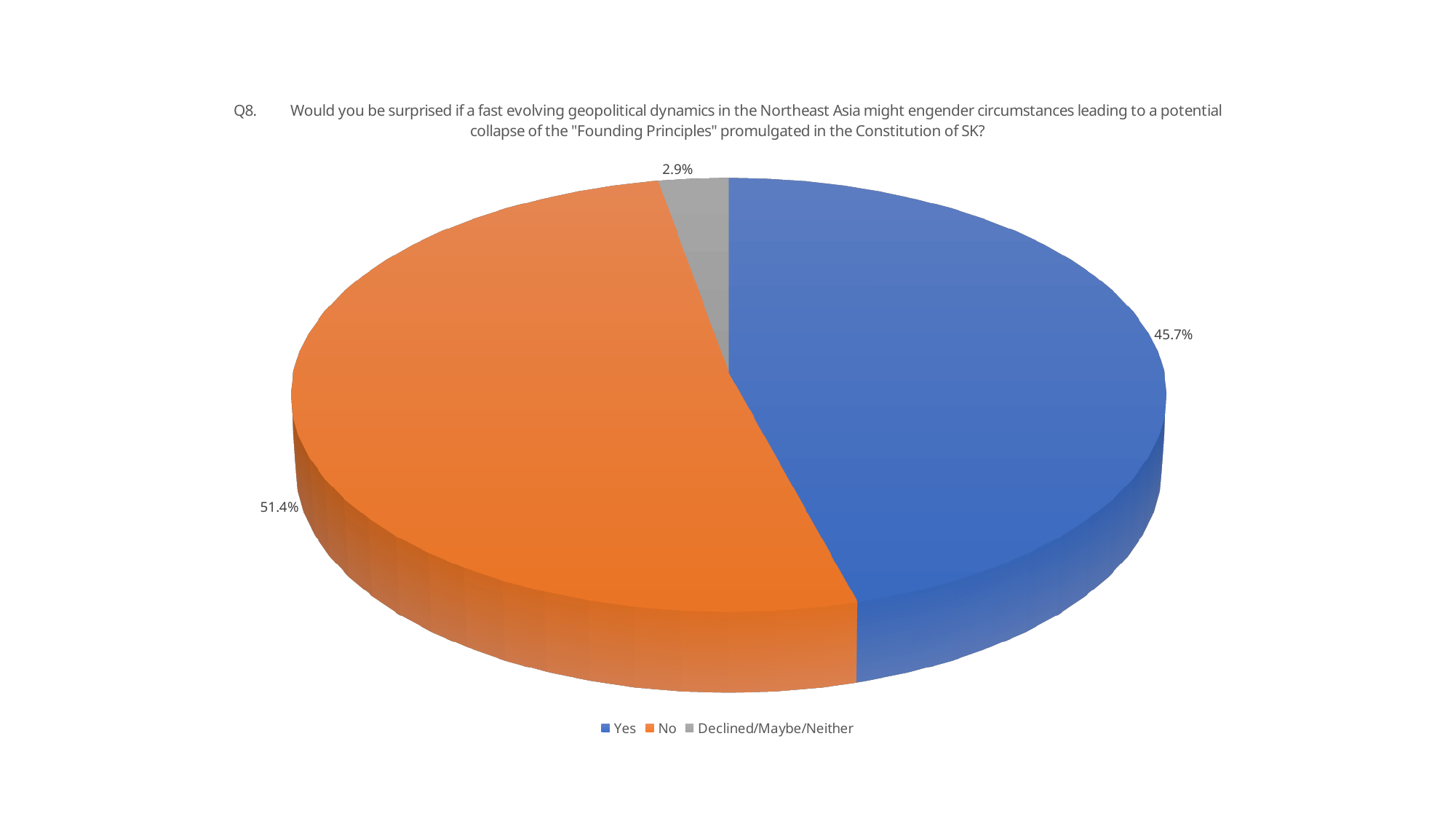
Which response has the smallest share of the pie? Declined/Maybe/Neither What percentage of respondents answered "No"? 51.4% What is the difference in percentage points between the "No" and "Yes" shares? 5.7 How many categories does the pie chart show? 3 Which response has the largest share of the pie? No Which is larger, the share for "Yes" or the share for "Declined/Maybe/Neither"? Yes What colour is the "No" slice? Orange What kind of chart is shown on the slide? Pie chart What is the combined share of "Yes" and "No" responses? 97.1% What percentage of respondents are in the "Declined/Maybe/Neither" category? 2.9% What percentage of respondents answered "Yes"? 45.7% Which question number is this chart about? Q8